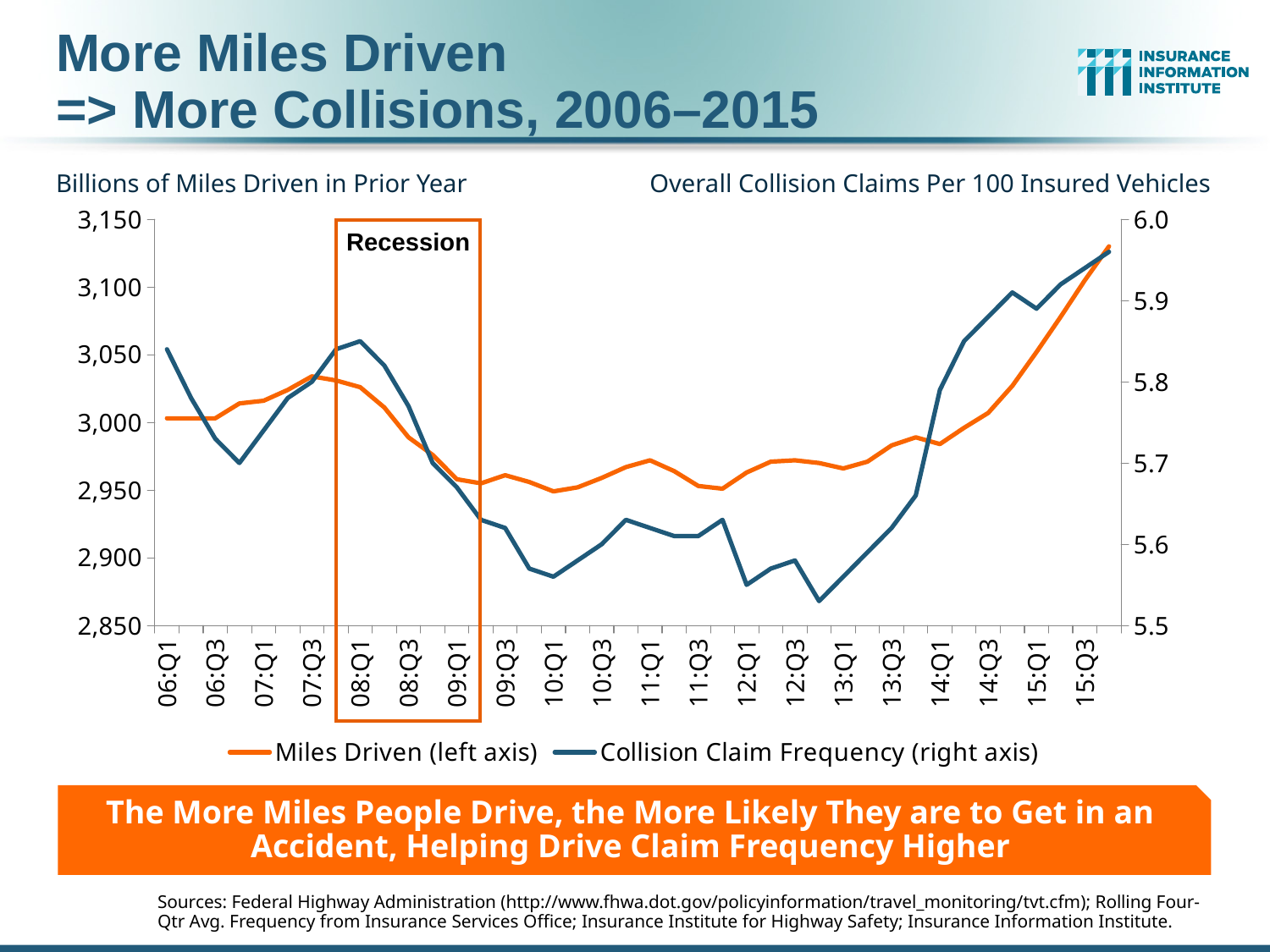
Is the Collision Claim Frequency value at 10:Q1 greater or less than 5.6? less What label is shown in the highlighted box over 2008–2009? Recession At which quarter does Miles Driven reach its highest value? 15:Q4 How many series does the legend list? 2 Is the Miles Driven value at 12:Q1 greater or less than 2,950? greater Does Collision Claim Frequency rise or fall from 08:Q1 to 09:Q3? fall Is the Collision Claim Frequency value at 06:Q1 greater or less than 5.8? greater Which series is plotted against the right axis? Collision Claim Frequency Does Miles Driven rise or fall from 13:Q3 to 15:Q3? rise What kind of chart is shown on the slide? Line chart Which is larger, the Collision Claim Frequency at 06:Q1 or at 10:Q1? 06:Q1